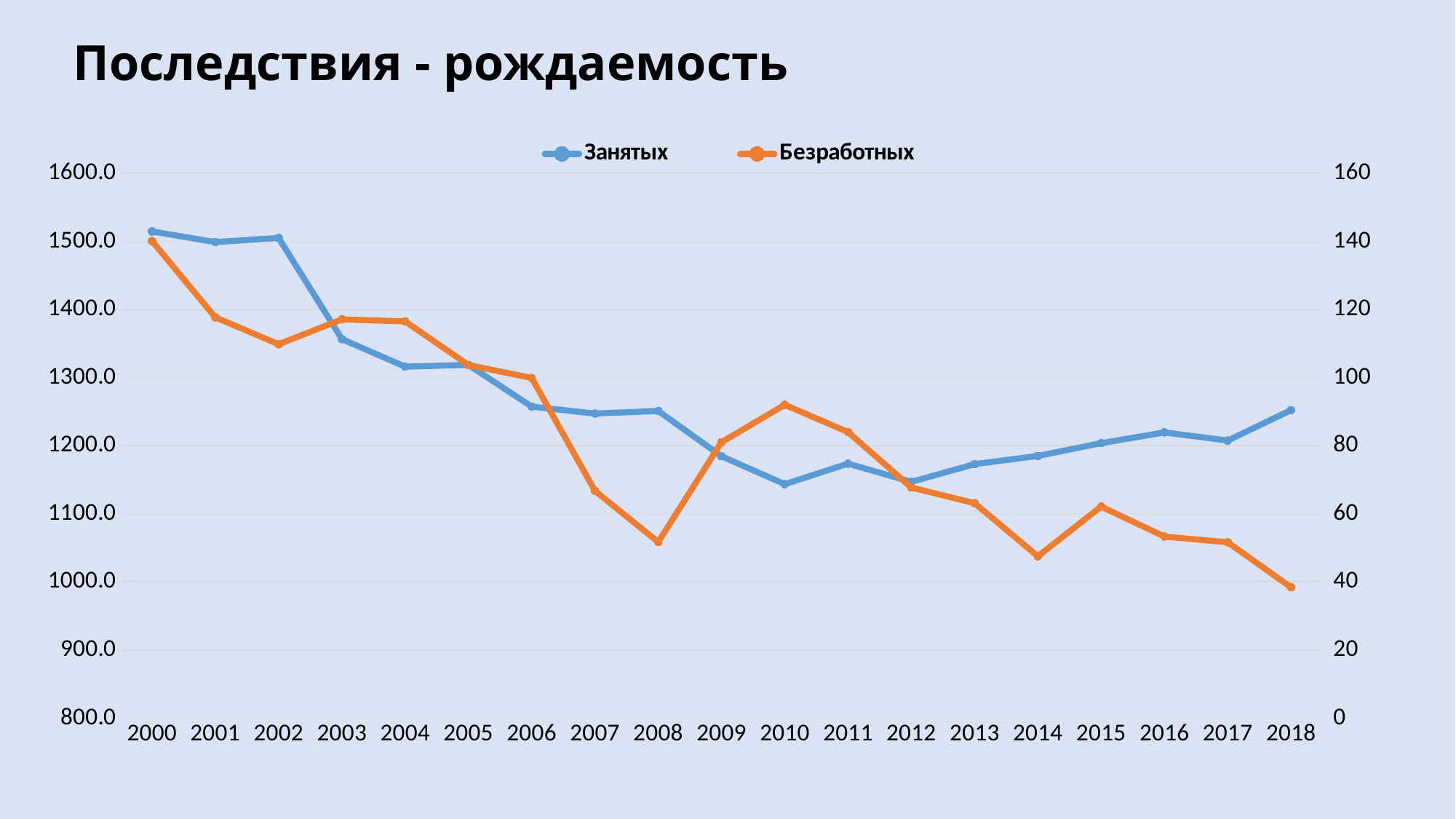
How many series does the legend list? 2 Does the Безработных series overall rise or fall from 2000 to 2018? fall Is the value for Занятых in 2018 greater or less than 1200.0? greater Which colour is used for the Безработных series? orange How many years are plotted along the x axis? 19 Is the value for Безработных in 2008 greater or less than 60? less What is the title of the slide? Последствия - рождаемость Is the value for Занятых in 2010 greater or less than 1200.0? less What kind of chart is shown on the slide? line chart In which year is the Безработных series at its highest? 2000 In which year is the Безработных series at its lowest? 2018